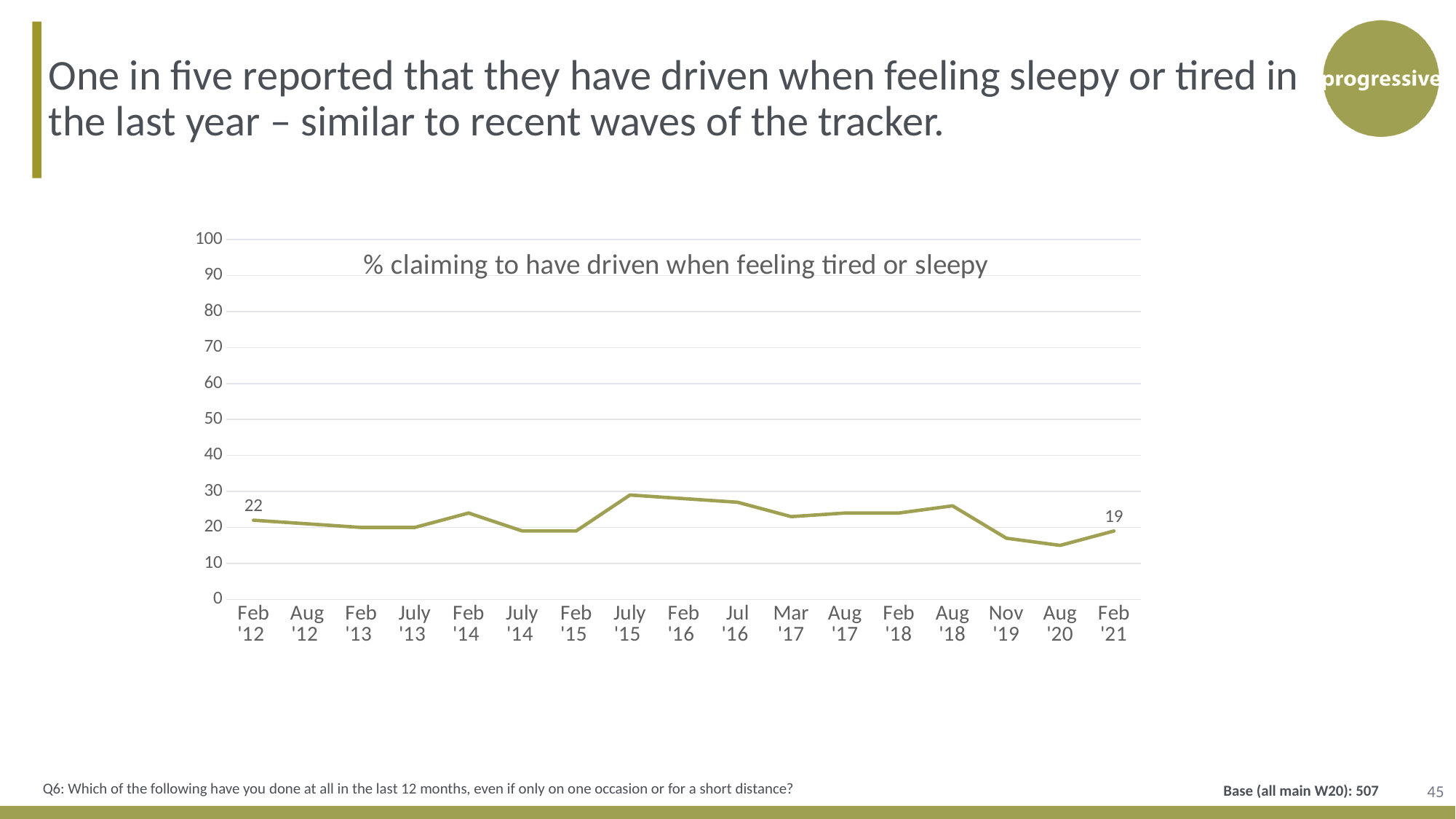
Which is larger, the value for Feb '12 or the value for Feb '21? Feb '12 What is the difference between the values for Feb '12 and Feb '21? 3 Do the values rise or fall from Aug '18 to Aug '20? fall What kind of chart is shown on the slide? Line chart What is the title of the chart? % claiming to have driven when feeling tired or sleepy What is the value for Feb '12? 22 Is the value for July '15 greater or less than 20? greater Which time point has the highest value? July '15 What is the value for Feb '21? 19 How many time points are plotted on the x axis? 17 Is the value for Aug '20 greater or less than 20? less Which time point has the lowest value? Aug '20